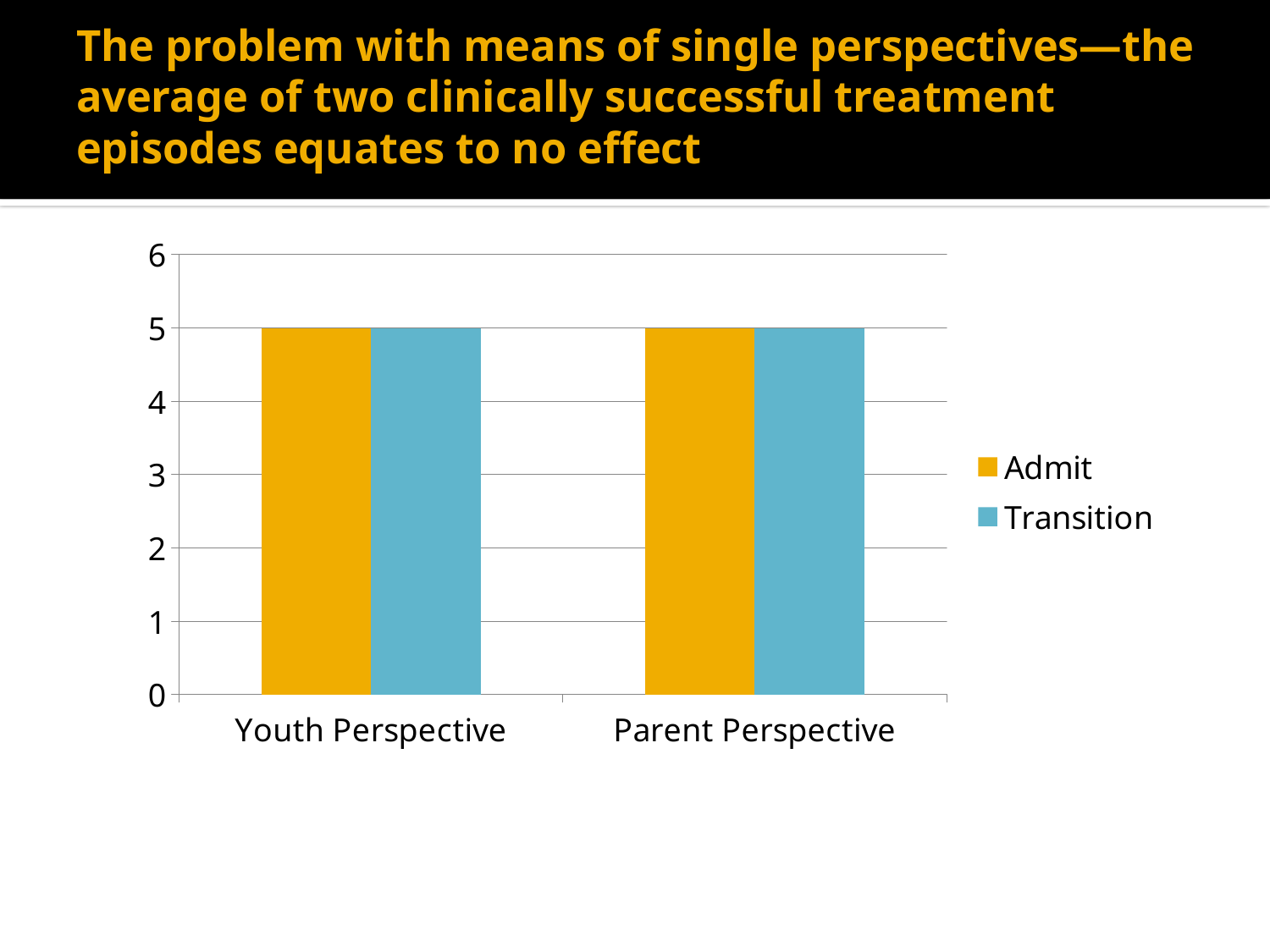
What is the difference between the Admit value for Youth Perspective and the Admit value for Parent Perspective? 0 What is the Admit value for Parent Perspective? 5 What is the Admit value for Youth Perspective? 5 What is the difference between the Admit and Transition values for Youth Perspective? 0 What is the Transition value for Youth Perspective? 5 How many series does the legend list? 2 Which series is shown in blue in the legend? Transition Is the Transition value for Parent Perspective greater or less than 4? greater What kind of chart is shown on the slide? bar chart What is the Transition value for Parent Perspective? 5 Is the Admit value for Youth Perspective greater or less than 6? less How many categories are shown on the x axis? 2